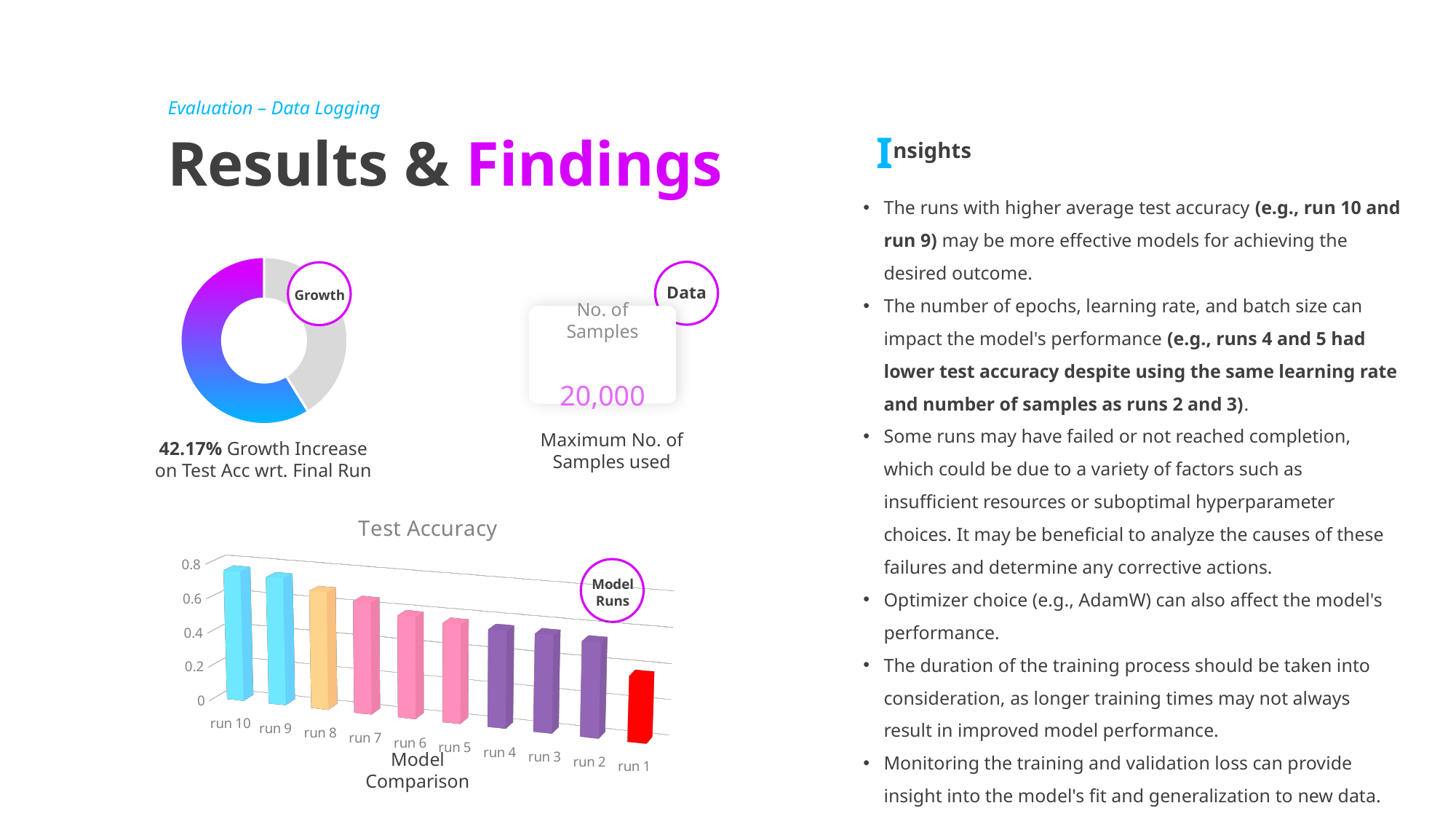
What kind of chart is the Test Accuracy chart? bar chart What growth increase on test accuracy is stated below the donut chart? 42.17% In the Test Accuracy chart, which has the higher test accuracy, run 10 or run 1? run 10 In the Test Accuracy chart, is the value for run 1 greater or less than 0.2? greater In the Test Accuracy chart, which run has the lowest test accuracy? run 1 In the Test Accuracy chart, is the value for run 10 greater or less than 0.6? greater In the Test Accuracy chart, which has the higher test accuracy, run 8 or run 4? run 8 In the Test Accuracy chart, is the value for run 2 greater or less than 0.6? less What is the title of the bar chart on the slide? Test Accuracy In the Test Accuracy chart, do the values rise or fall moving from run 10 on the left to run 1 on the right? fall How many runs are plotted in the Test Accuracy chart? 10